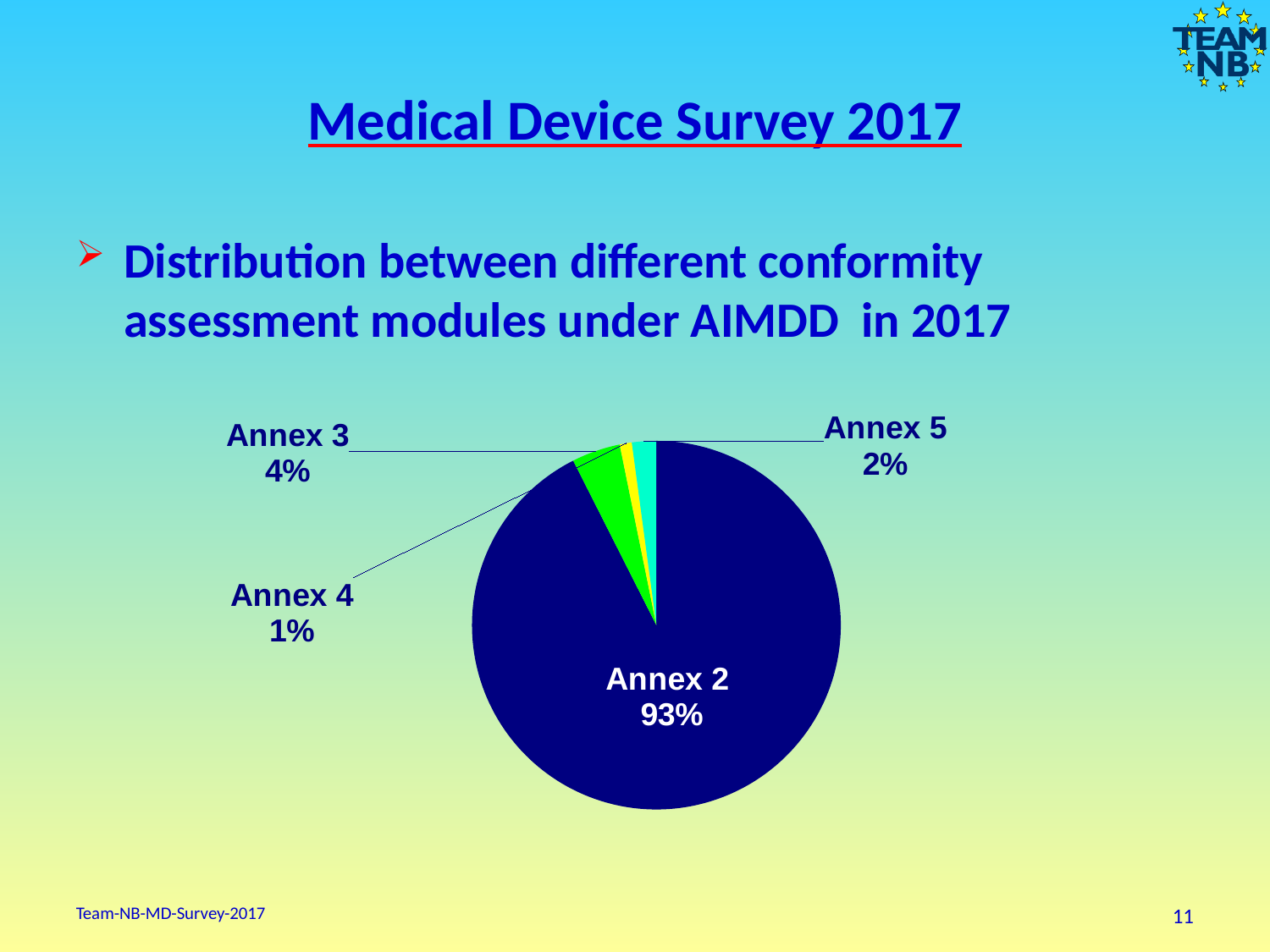
What colour is the Annex 2 slice of the pie? dark blue How many slices does the pie chart have? 4 What kind of chart is shown on the slide? pie chart What is the difference in percentage points between Annex 2 and Annex 3? 89% What share of the pie does Annex 2 represent? 93% Which annex has the smallest slice of the pie? Annex 4 What share of the pie does Annex 3 represent? 4% Which annex has the largest slice of the pie? Annex 2 What share of the pie does Annex 5 represent? 2% What is the difference in percentage points between Annex 3 and Annex 5? 2% Which is larger, the share for Annex 5 or the share for Annex 4? Annex 5